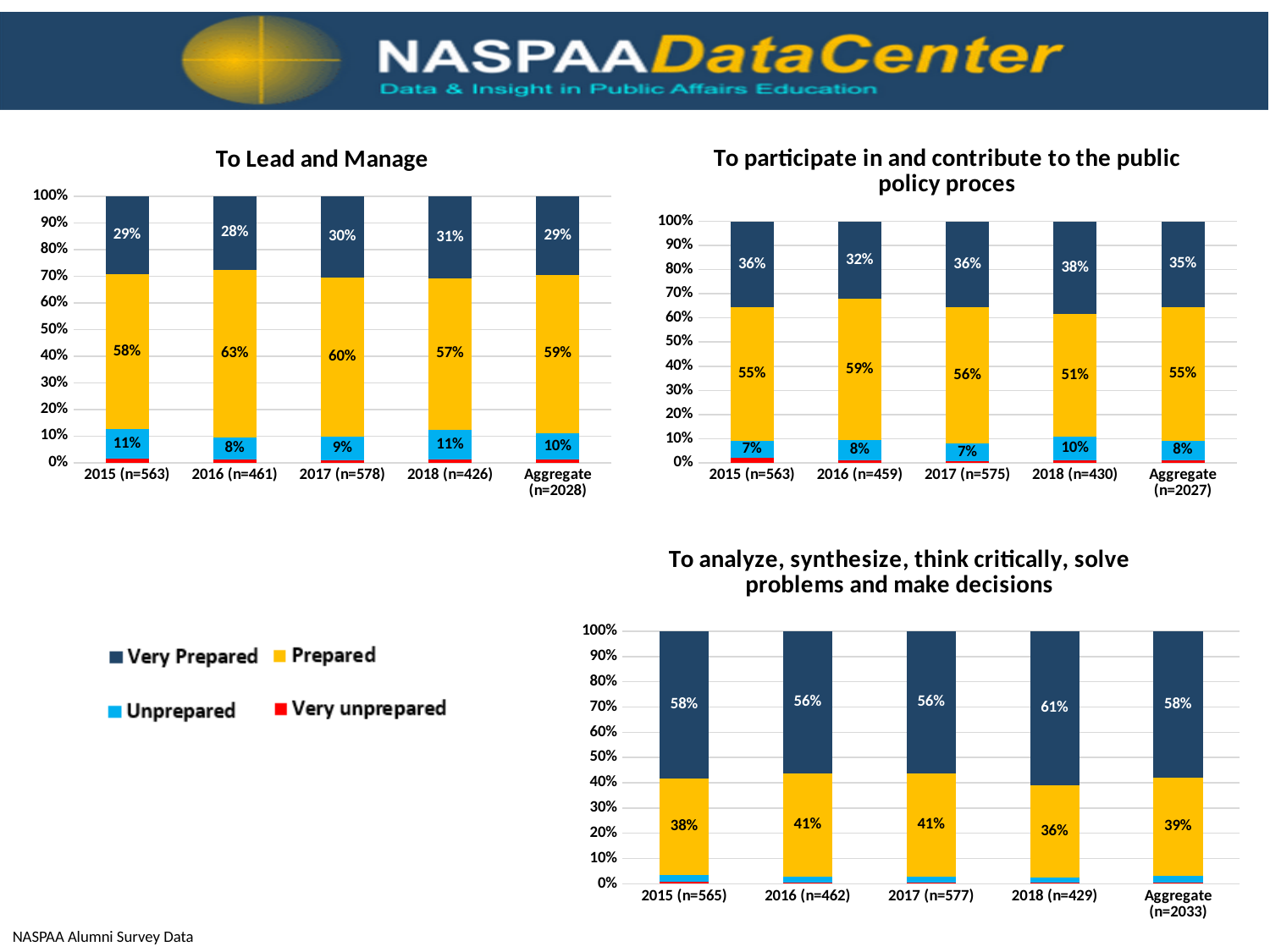
In the 'To Lead and Manage' chart, what is the Very Prepared value for 2018 (n=426)? 31% In the 'To analyze, synthesize, think critically, solve problems and make decisions' chart, what is the Very Prepared value for 2018 (n=429)? 61% In the 'To Lead and Manage' chart, which category has the highest Prepared value? 2016 (n=461) How many categories are shown on the x axis of the 'To Lead and Manage' chart? 5 In the 'To participate in and contribute to the public policy proces' chart, which category has the lowest Very Prepared value? 2016 (n=459) In the 'To participate in and contribute to the public policy proces' chart, what is the difference between the Prepared values for 2016 (n=459) and 2018 (n=430)? 8% How many series does the legend on the slide list? 4 In the 'To analyze, synthesize, think critically, solve problems and make decisions' chart, which is larger, the Prepared value for 2016 (n=462) or for 2018 (n=429)? 2016 (n=462) What type of chart is the 'To Lead and Manage' chart? Stacked bar chart In the 'To participate in and contribute to the public policy proces' chart, what is the Prepared value for 2018 (n=430)? 51% In the 'To analyze, synthesize, think critically, solve problems and make decisions' chart, which category has the lowest Prepared value? 2018 (n=429) In the 'To Lead and Manage' chart, what percentage of 2016 (n=461) respondents were Prepared? 63%